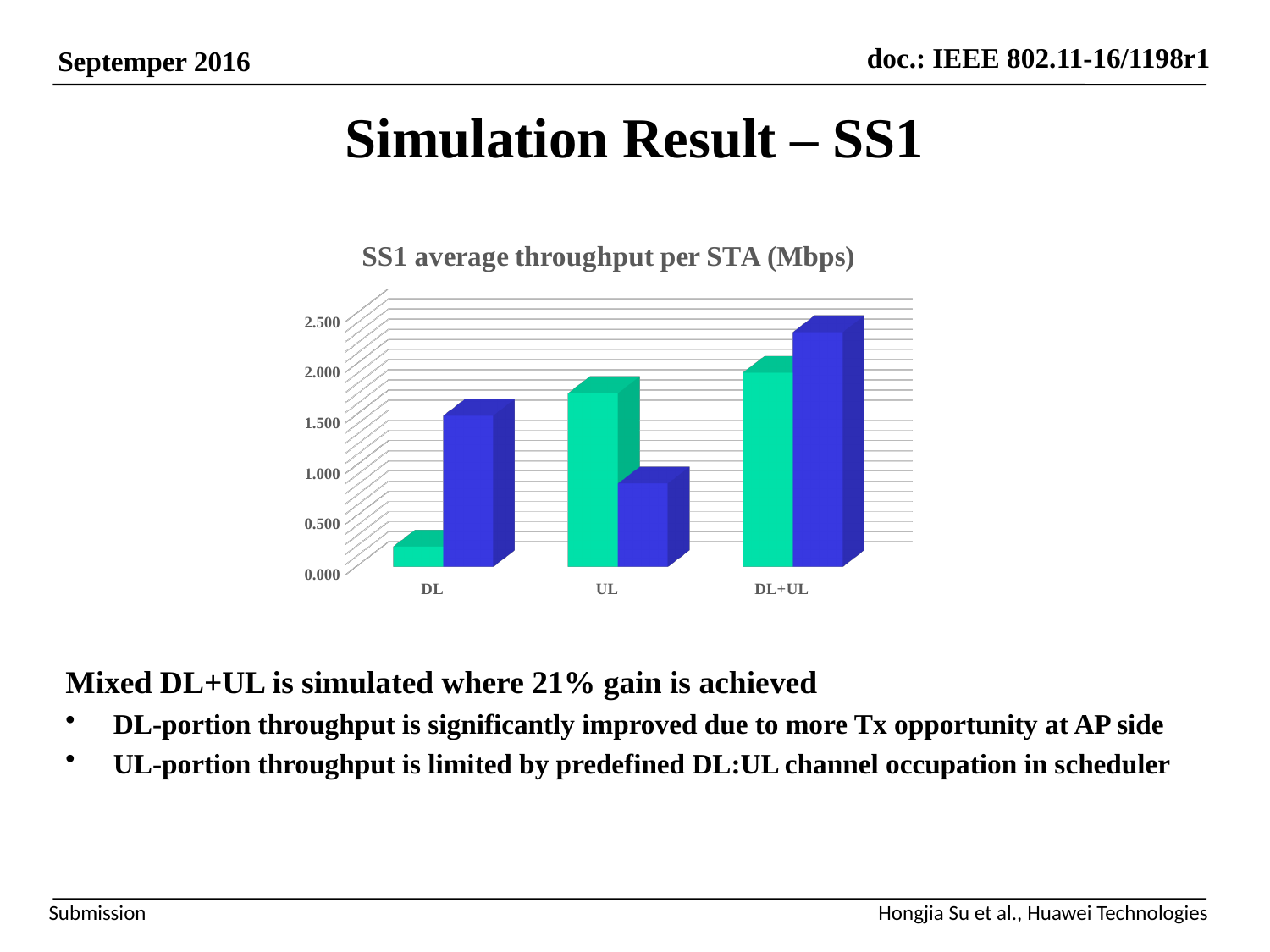
Is the value of the blue bar for DL+UL greater or less than 2.000? greater Is the value of the green bar for UL greater or less than 1.500? greater Is the value of the blue bar for DL greater or less than 1.000? greater What is the title of the chart? SS1 average throughput per STA (Mbps) Which category has the shortest green bar? DL For the DL category, which bar is taller, the green one or the blue one? the blue one Which category has the tallest blue bar? DL+UL What kind of chart is shown on the slide? bar chart How many categories are shown on the x axis of the chart? 3 Do the green bars rise or fall from DL to DL+UL along the x axis? rise